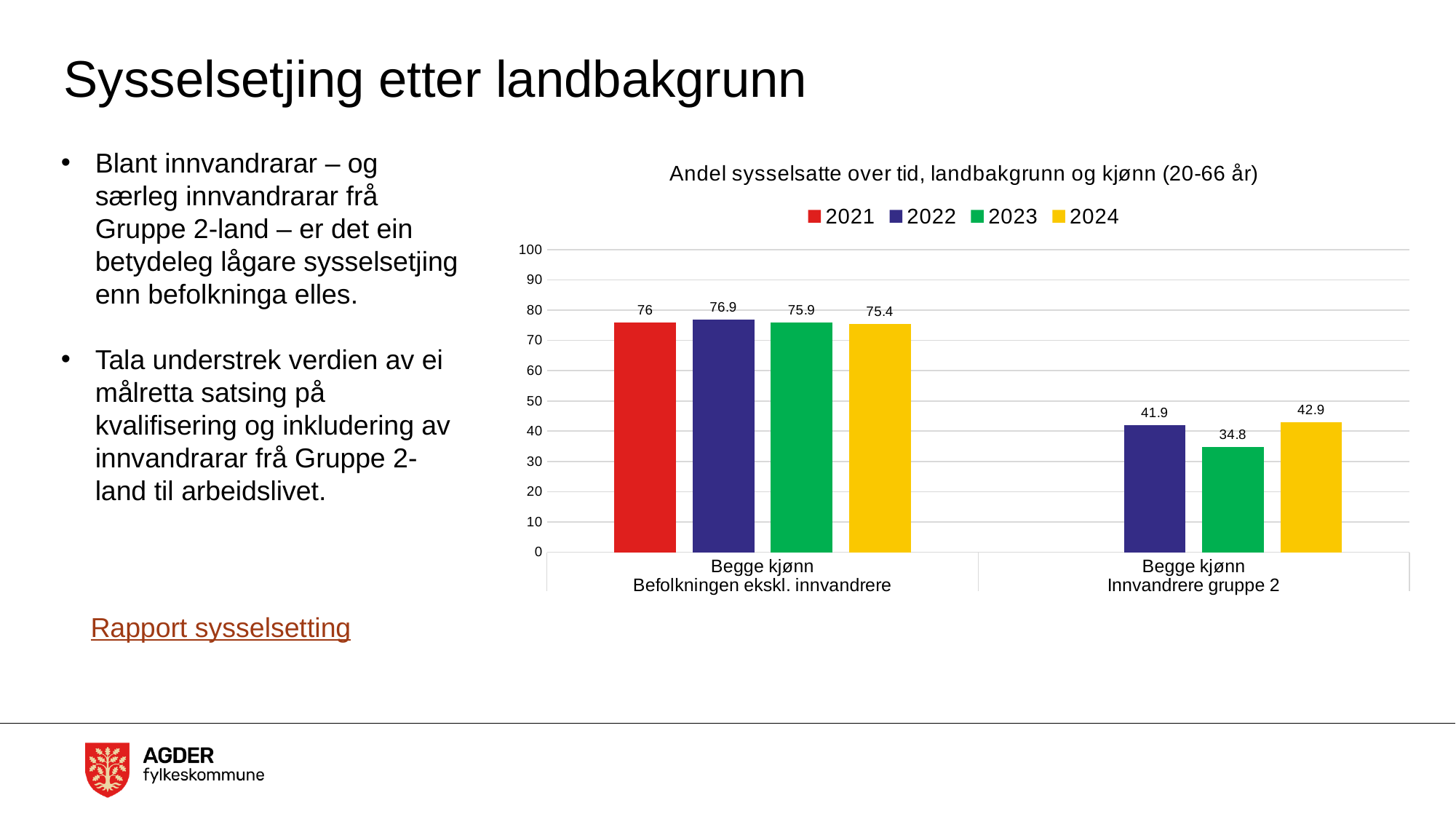
What is the value for 2022 in the 'Begge kjønn Befolkningen ekskl. innvandrere' category? 76.9 Which year has the highest value in the 'Begge kjønn Befolkningen ekskl. innvandrere' category? 2022 What is the value for 2021 in the 'Begge kjønn Befolkningen ekskl. innvandrere' category? 76 What is the title of the chart? Andel sysselsatte over tid, landbakgrunn og kjønn (20-66 år) What is the value for 2023 in the 'Begge kjønn Innvandrere gruppe 2' category? 34.8 Which is larger: the 2022 value for 'Innvandrere gruppe 2' or the 2024 value for 'Innvandrere gruppe 2'? 2024 How many series does the legend list? 4 Which year is shown in red in the chart legend? 2021 What is the difference between the 2024 values for 'Befolkningen ekskl. innvandrere' and 'Innvandrere gruppe 2'? 32.5 What kind of chart is shown on the slide? Bar chart What is the value for 2024 in the 'Begge kjønn Innvandrere gruppe 2' category? 42.9 Which year has the lowest value in the 'Begge kjønn Innvandrere gruppe 2' category? 2023